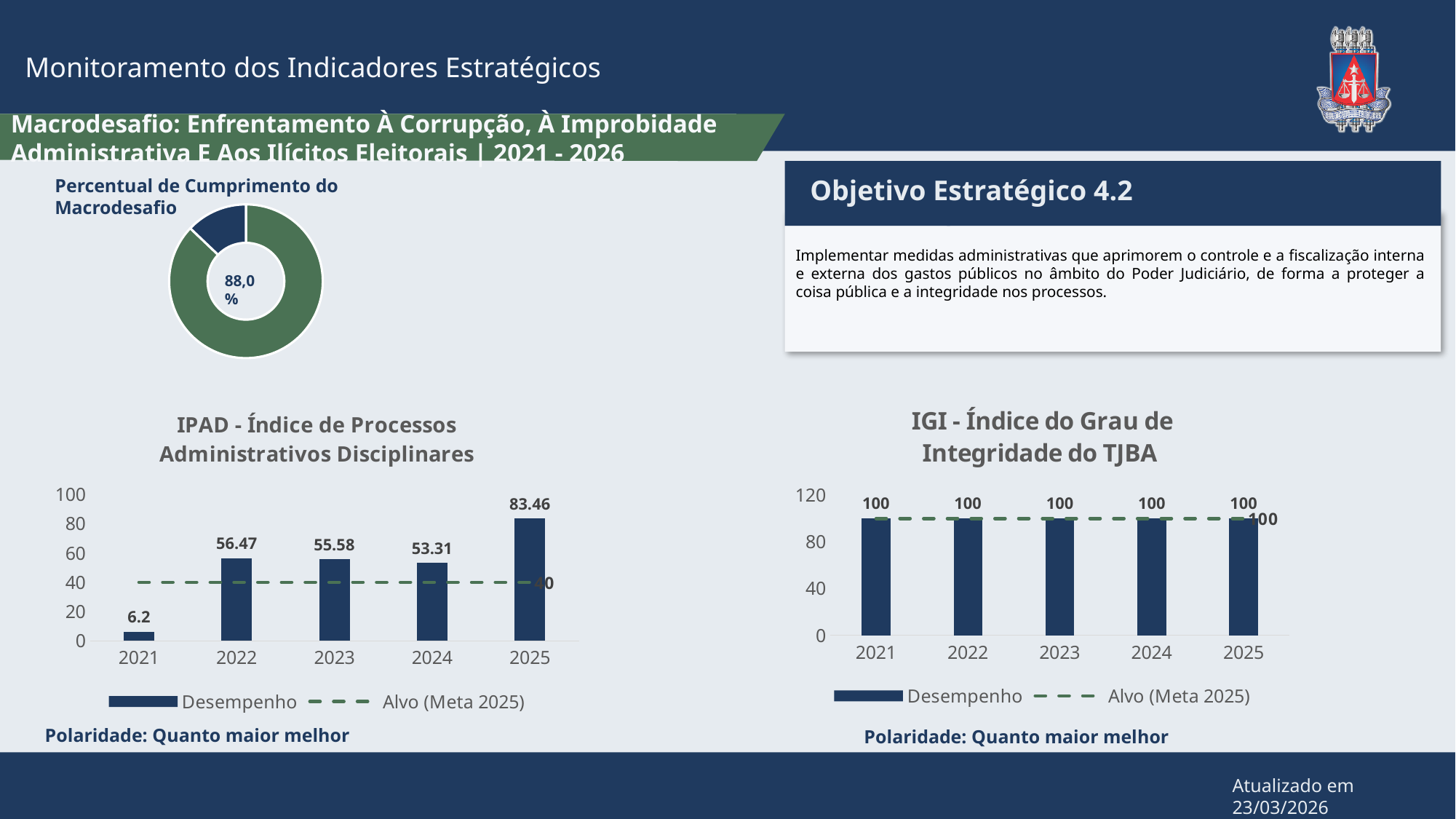
In the IPAD - Índice de Processos Administrativos Disciplinares chart, which year has the highest Desempenho value? 2025 What percentage is shown in the Percentual de Cumprimento do Macrodesafio chart? 88,0% In the IPAD - Índice de Processos Administrativos Disciplinares chart, what is the Alvo (Meta 2025) value? 40 In the IPAD - Índice de Processos Administrativos Disciplinares chart, what is the difference between the Desempenho values for 2022 and 2024? 3.16 In the IGI - Índice do Grau de Integridade do TJBA chart, what is the Desempenho value for 2023? 100 In the IPAD - Índice de Processos Administrativos Disciplinares chart, what is the Desempenho value for 2021? 6.2 How many years are shown on the x axis of the IGI - Índice do Grau de Integridade do TJBA chart? 5 How many series does the legend of the IPAD - Índice de Processos Administrativos Disciplinares chart list? 2 In the IPAD - Índice de Processos Administrativos Disciplinares chart, which year has the lowest Desempenho value? 2021 In the IPAD - Índice de Processos Administrativos Disciplinares chart, which is larger, the Desempenho value for 2022 or for 2023? 2022 What kind of chart is the Percentual de Cumprimento do Macrodesafio chart? Donut chart In the IPAD - Índice de Processos Administrativos Disciplinares chart, what is the Desempenho value for 2025? 83.46